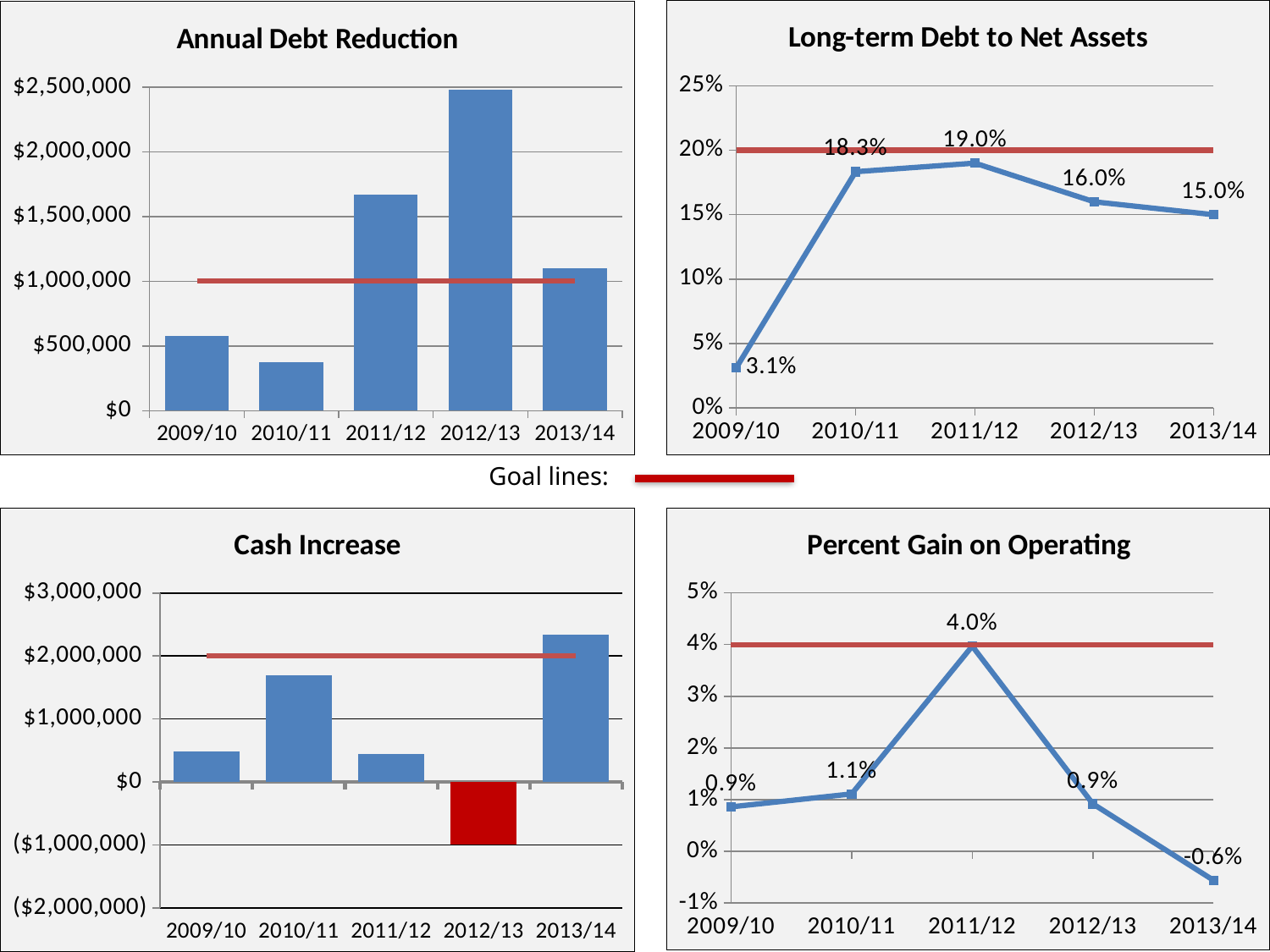
In the Long-term Debt to Net Assets chart, what is the value for 2009/10? 3.1% In the Cash Increase chart, is the value for 2013/14 greater or less than $2,000,000? greater In the Annual Debt Reduction chart, is the value for 2012/13 greater or less than $2,000,000? greater In the Annual Debt Reduction chart, which year has the lowest bar? 2010/11 In the Long-term Debt to Net Assets chart, what is the value for 2011/12? 19.0% What kind of chart is the Cash Increase chart? Bar chart In the Cash Increase chart, which year has the lowest value? 2012/13 In the Percent Gain on Operating chart, what is the value for 2013/14? -0.6% In the Percent Gain on Operating chart, which year has the highest value? 2011/12 In the Annual Debt Reduction chart, is the value for 2010/11 greater or less than $500,000? less In the Annual Debt Reduction chart, which year has the highest bar? 2012/13 In the Long-term Debt to Net Assets chart, what is the difference between the 2011/12 and 2013/14 values? 4.0 percentage points